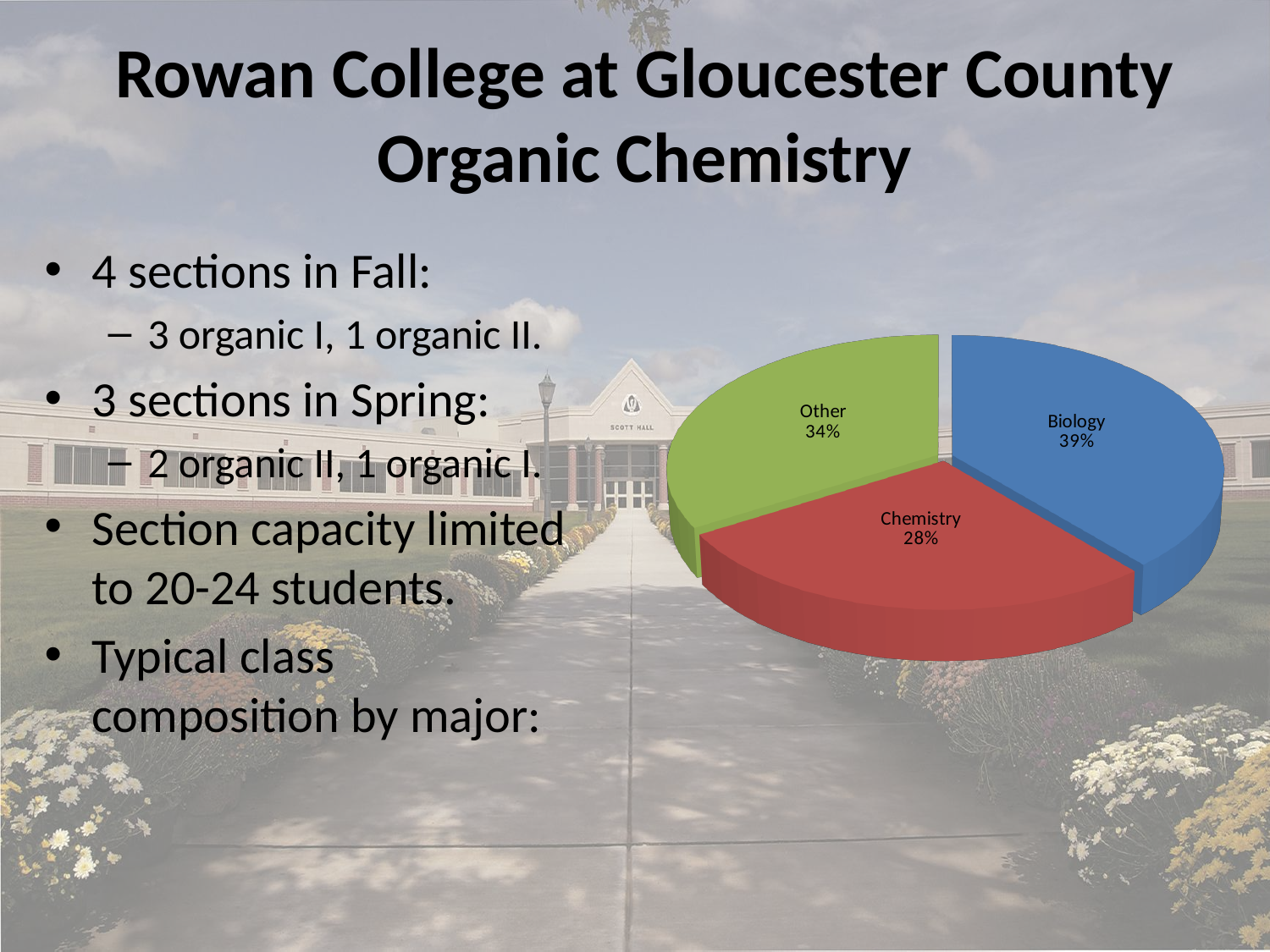
What colour is the Biology slice? blue What kind of chart is shown on the slide? pie chart What is the difference in percentage points between the Other and Chemistry slices? 6 What share of the pie does Other have? 34% What is the difference in percentage points between the Biology and Chemistry slices? 11 Which slice of the pie is the smallest? Chemistry What colour is the Chemistry slice? red Which slice of the pie is the largest? Biology Which is larger, the Other slice or the Chemistry slice? Other What share of the pie does Chemistry have? 28% What share of the pie does Biology have? 39% How many slices does the pie chart have? 3